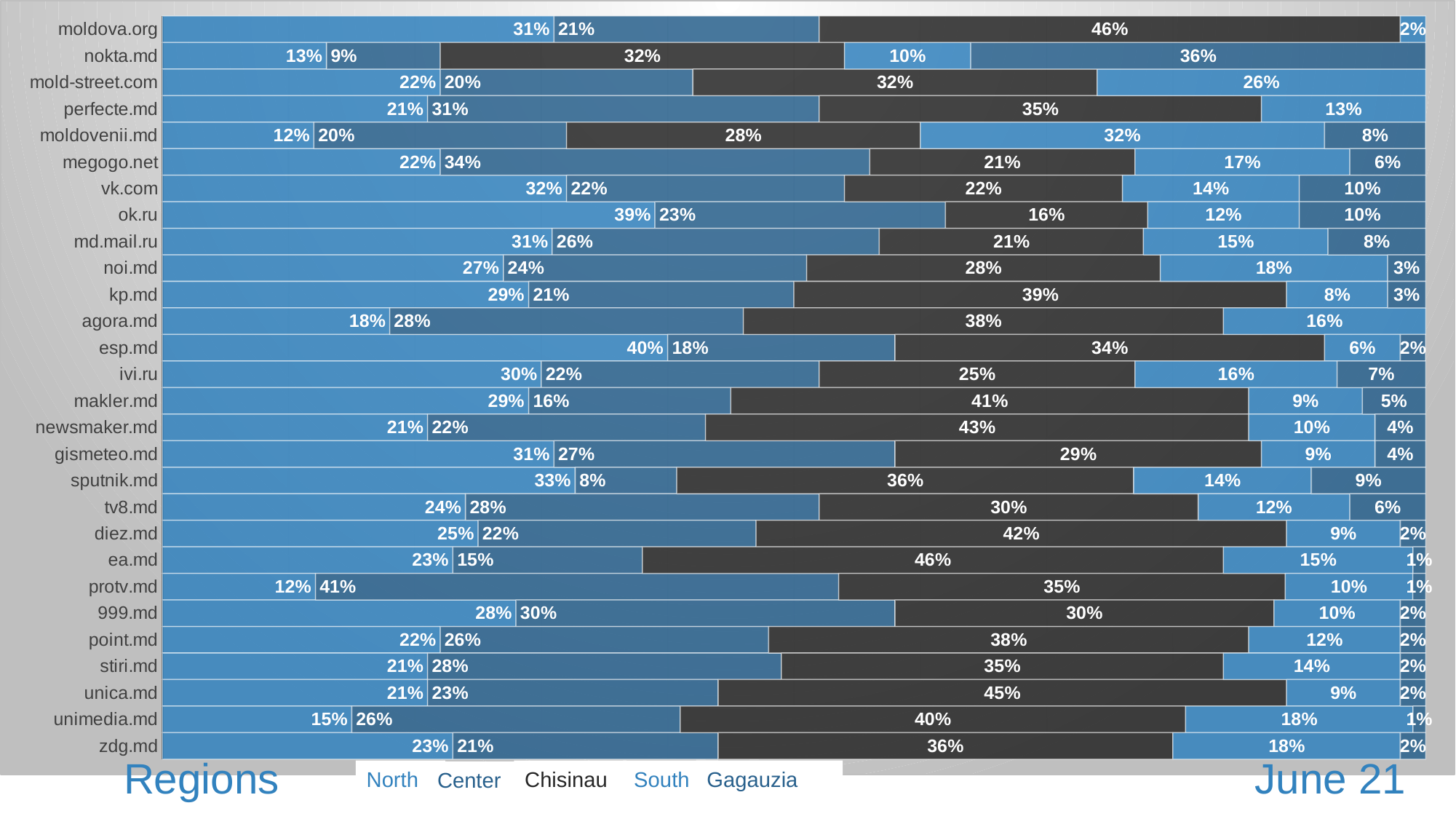
How many series does the legend list? 5 What is the Chisinau value for unica.md? 45% What is the Center value for protv.md? 41% Which is larger: the Chisinau value for kp.md or the Chisinau value for noi.md? kp.md What is the South value for mold-street.com? 26% What are the legend entries listed at the bottom of the chart? North, Center, Chisinau, South, Gagauzia Which website has the lowest Chisinau value? ok.ru What is the difference between the Chisinau value and the North value for kp.md? 10% What is the Chisinau value for moldova.org? 46% How many websites (categories) are plotted in the chart? 28 What is the North value for esp.md? 40% What kind of chart is shown on the slide? Stacked bar chart